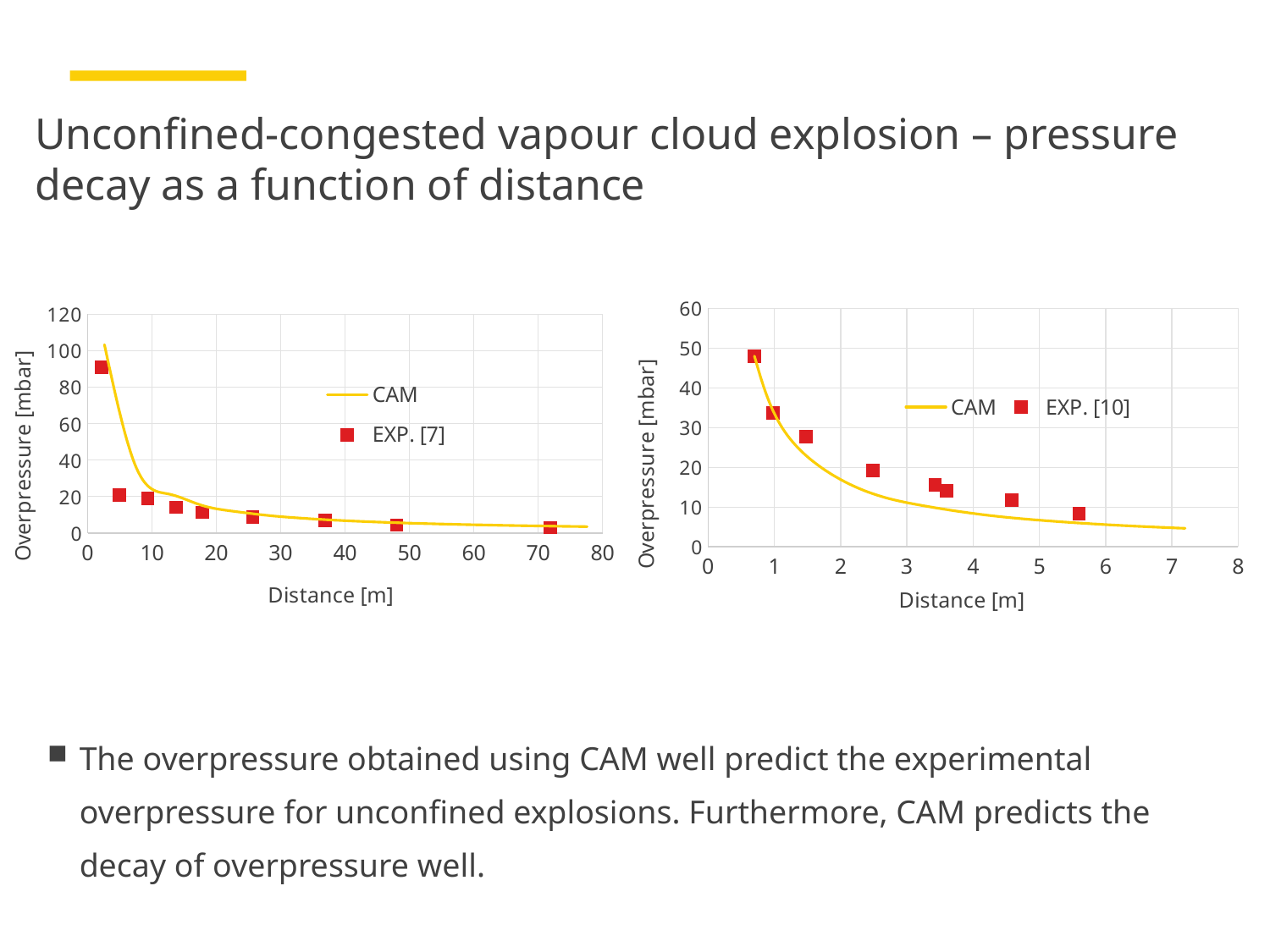
On the right chart, does the EXP. [10] overpressure rise or fall as distance increases? Fall On the right chart, is the EXP. [10] value at about 5.6 m greater or less than 10 mbar? less On the left chart, which is larger: the EXP. [7] value at about 2 m or the EXP. [7] value at about 5 m? The value at about 2 m What kind of chart is the right chart? Line chart with scatter points On the right chart, is the first EXP. [10] point (at about 0.7 m) greater or less than 40 mbar? greater On the right chart, how many EXP. [10] data points are plotted? 8 On the left chart, how many series does the legend list? 2 On the right chart, what are the two series named in the legend? CAM and EXP. [10] On the left chart, does the CAM overpressure rise or fall as distance increases? Fall On the left chart, what is the name of the experimental series in the legend? EXP. [7] On the left chart, is the EXP. [7] value at about 71 m greater or less than 20 mbar? less